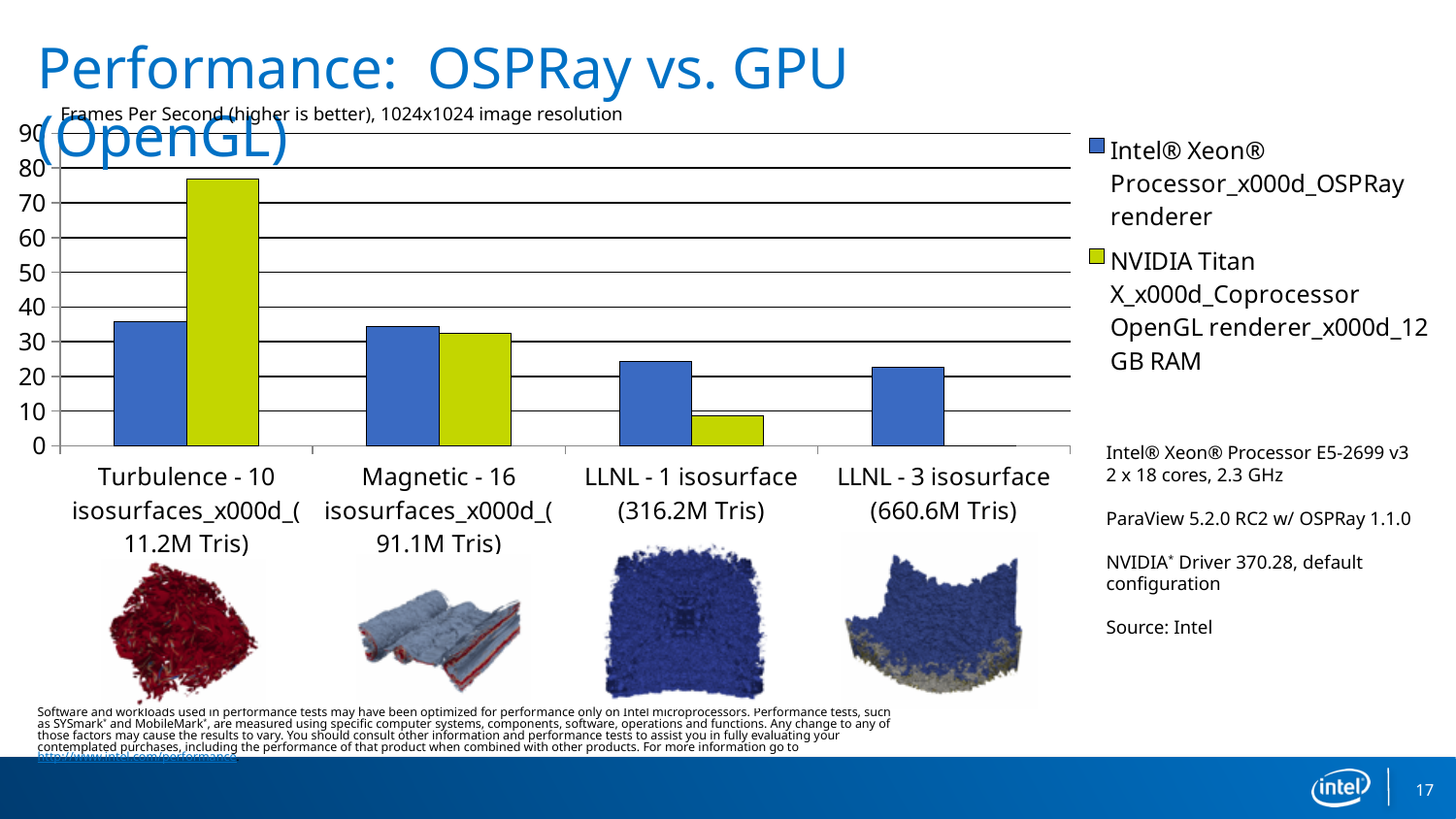
For Turbulence - 10 isosurfaces, which renderer has the higher frames per second, Intel Xeon OSPRay or NVIDIA Titan X OpenGL? NVIDIA Titan X OpenGL renderer How many series does the chart legend list? 2 What does the y axis of the chart measure? Frames Per Second (higher is better), 1024x1024 image resolution Is the Intel Xeon Processor OSPRay renderer value for Turbulence - 10 isosurfaces greater or less than 40? less How many dataset categories are plotted along the x axis? 4 Which dataset has the highest NVIDIA Titan X OpenGL renderer value? Turbulence - 10 isosurfaces (11.2M Tris) What kind of chart is shown on the slide? bar chart Do the Intel Xeon Processor OSPRay renderer values rise or fall from left to right across the datasets? fall For LLNL - 1 isosurface, which renderer has the higher frames per second, Intel Xeon OSPRay or NVIDIA Titan X OpenGL? Intel Xeon Processor OSPRay renderer Is the Intel Xeon Processor OSPRay renderer value for LLNL - 3 isosurface greater or less than 30? less Is the NVIDIA Titan X OpenGL renderer value for Turbulence - 10 isosurfaces greater or less than 70? greater